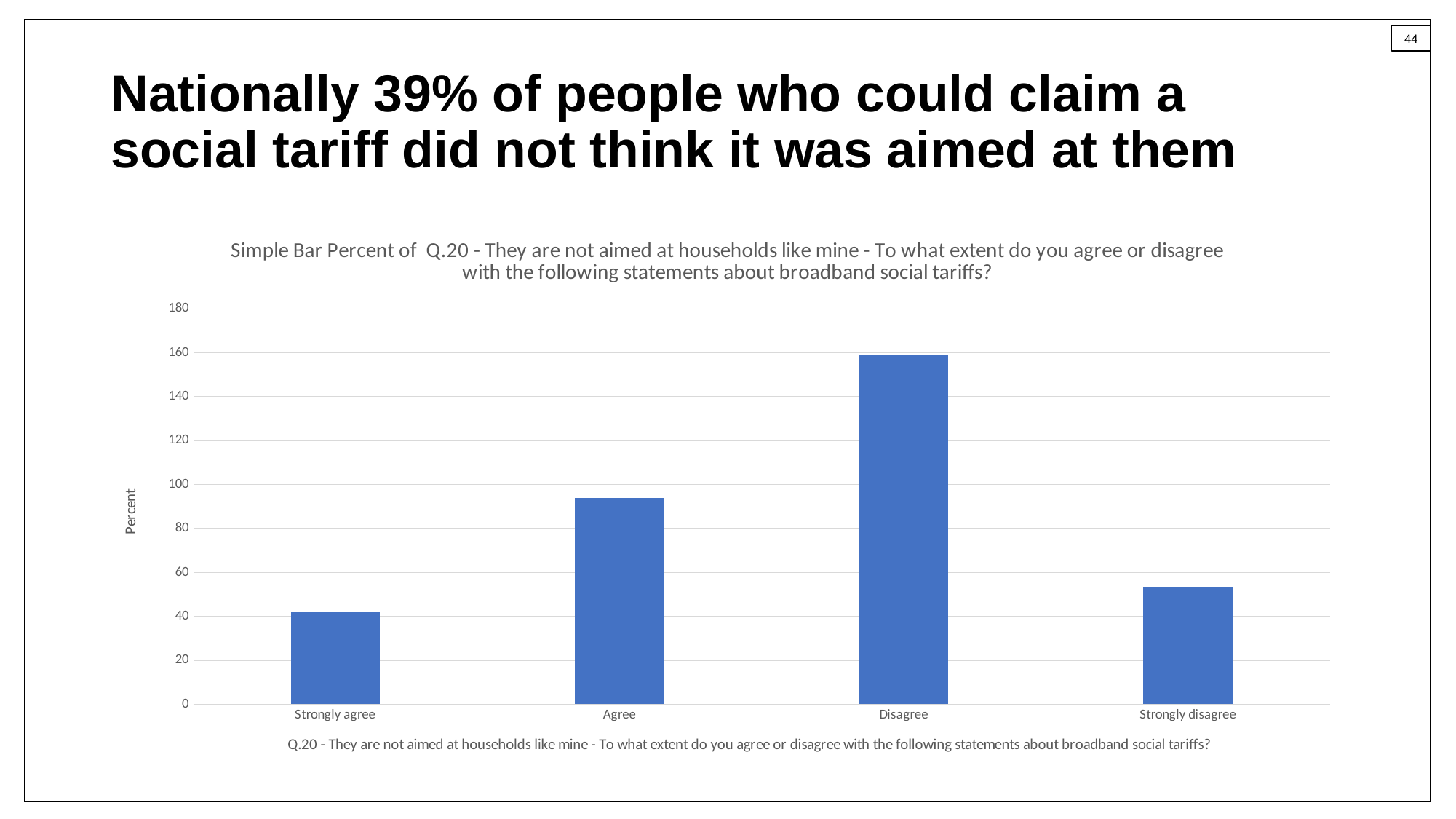
Which is larger, the value for Strongly agree or the value for Disagree? Disagree Which category has the highest bar in the chart? Disagree Which category has the lowest bar in the chart? Strongly agree What is the label on the vertical axis of the chart? Percent Is the value for Strongly disagree greater or less than 40? greater Is the value for Disagree greater or less than 140? greater How many categories are shown on the x axis of the chart? 4 Is the value for Agree greater or less than 100? less What kind of chart is shown on the slide? bar chart What is the highest value shown on the vertical axis of the chart? 180 Which is larger, the value for Agree or the value for Strongly disagree? Agree